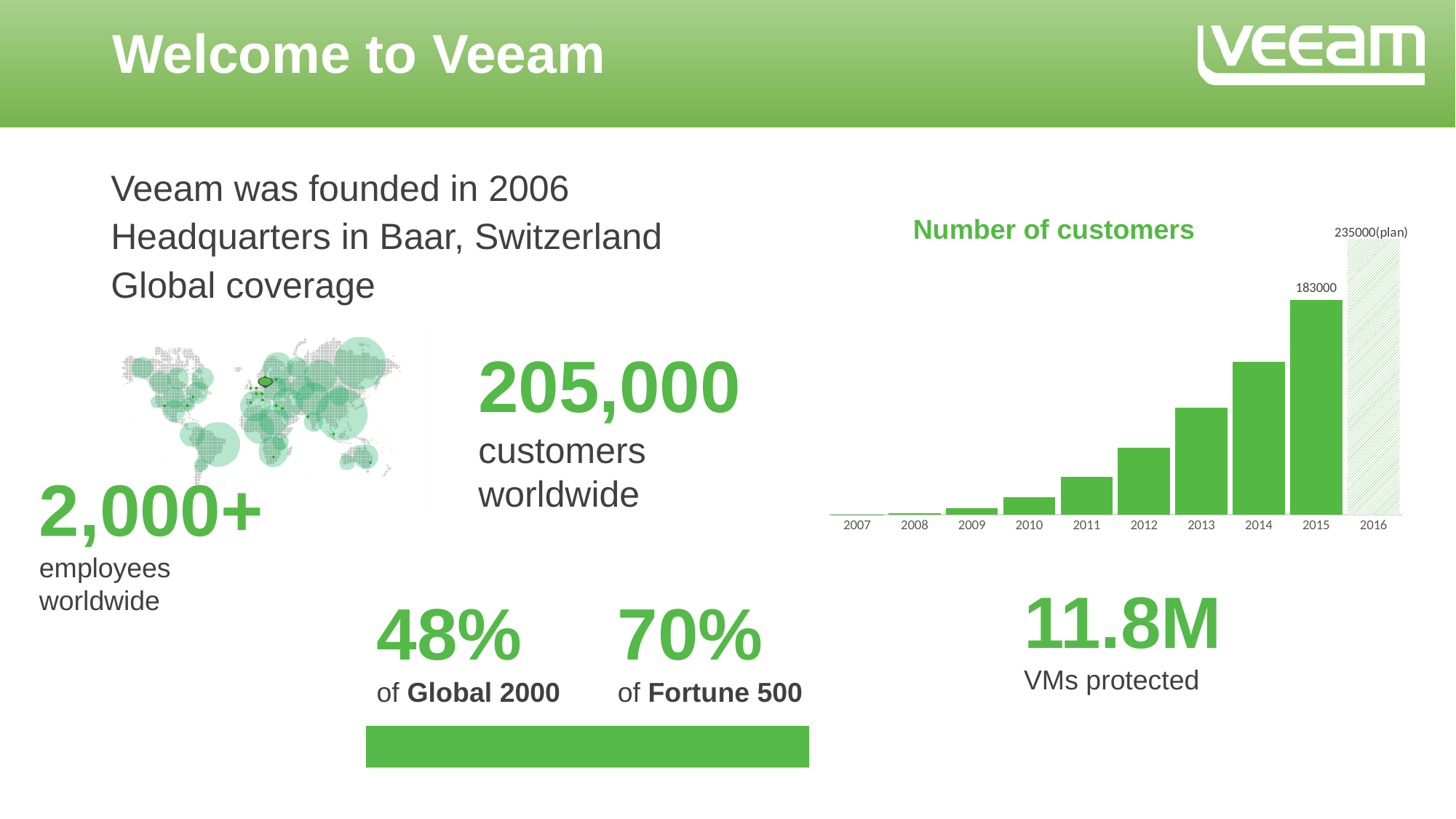
In the 'Number of customers' chart, what is the value for 2015? 183000 What is the title of the chart on the slide? Number of customers How many years are shown on the x axis of the 'Number of customers' chart? 10 In the 'Number of customers' chart, which year has the highest value among the solid (non-plan) bars? 2015 What kind of chart is the 'Number of customers' chart? bar chart In the 'Number of customers' chart, do the values rise or fall from 2007 to 2016? rise In the 'Number of customers' chart, which year has the highest value? 2016 In the 'Number of customers' chart, which year has the lowest value? 2007 In the 'Number of customers' chart, what is the value labelled for 2016? 235000(plan) In the 'Number of customers' chart, which year's bar is drawn with a hatched pattern instead of solid fill? 2016 In the 'Number of customers' chart, is the value for 2014 larger or smaller than the value for 2013? larger In the 'Number of customers' chart, what is the difference between the 2016 plan value and the 2015 value? 52000